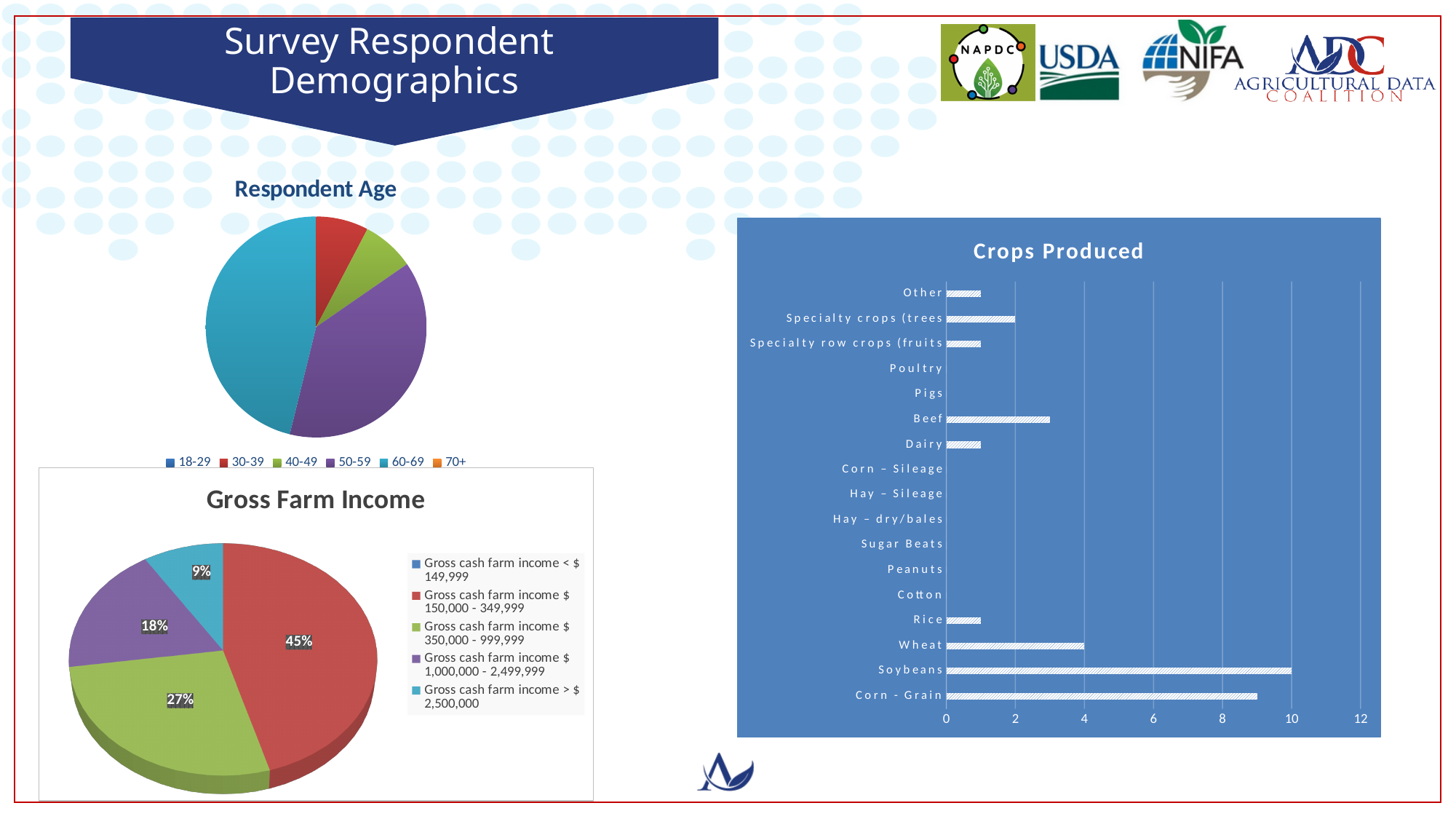
In the Crops Produced chart, which crop has the highest value? Soybeans In the Crops Produced chart, is the value for Corn - Grain greater or less than 8? greater In the Gross Farm Income chart, what share is shown for Gross cash farm income > $2,500,000? 9% What kind of chart is the Crops Produced chart? bar chart In the Crops Produced chart, what is the value for Soybeans? 10 In the Crops Produced chart, what is the value for Wheat? 4 In the Crops Produced chart, is the value for Beef greater or less than 2? greater In the Gross Farm Income chart, what share is shown for Gross cash farm income $150,000 - 349,999? 45% In the Gross Farm Income chart, what is the difference between the 45% slice and the 27% slice? 18% In the Crops Produced chart, which is larger, the value for Wheat or the value for Beef? Wheat What kind of chart is the Respondent Age chart? pie chart How many entries does the legend of the Respondent Age chart list? 6